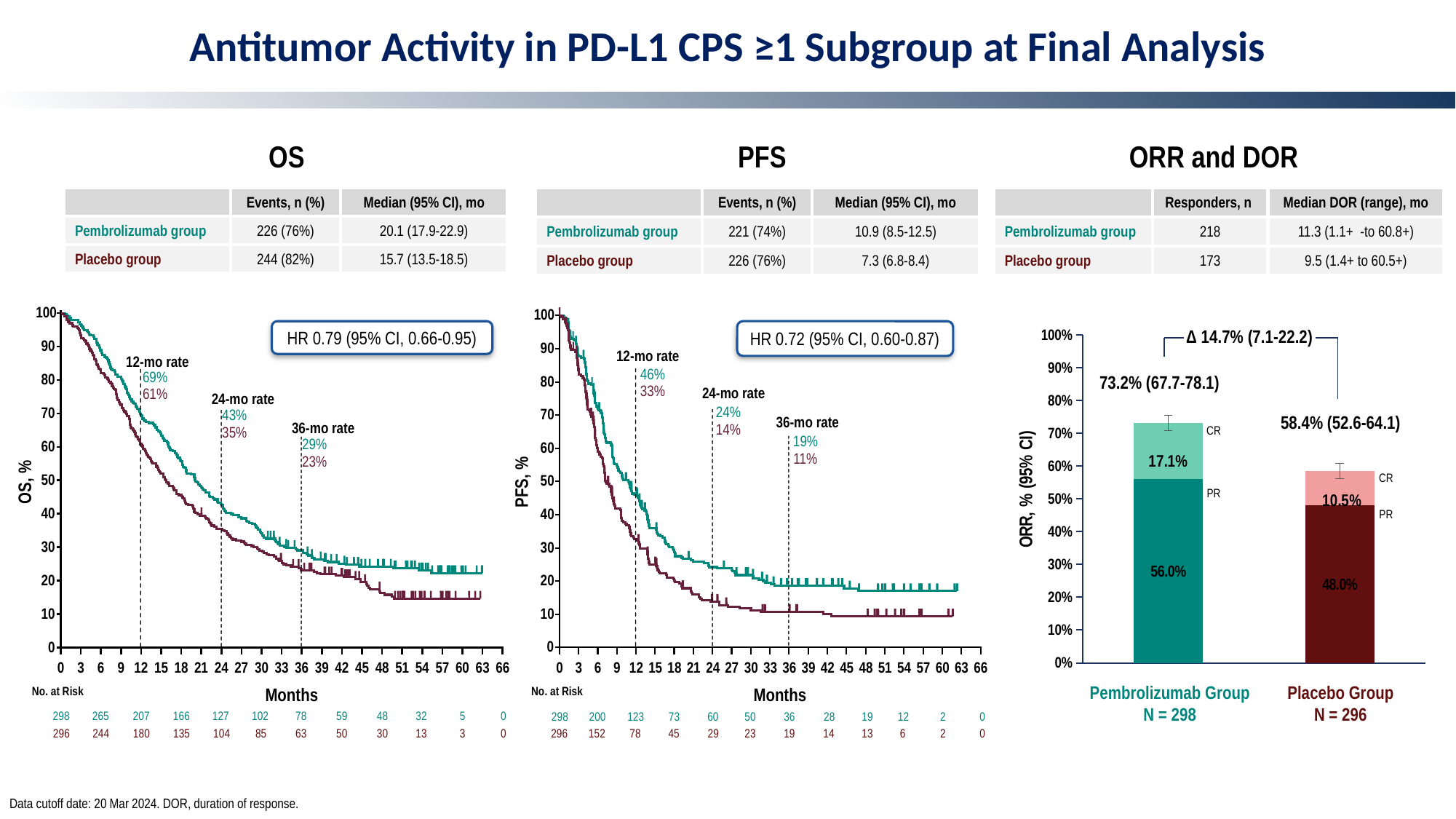
In the OS chart, what is the 12-mo rate for the pembrolizumab group? 69% What kind of chart is used to show ORR on the right of the slide? Bar chart In the ORR and DOR bar chart, what is the total ORR for the Pembrolizumab Group? 73.2% In the PFS chart, do the curves rise or fall as months increase? Fall In the ORR and DOR bar chart, which group has the higher overall response rate? Pembrolizumab Group In the ORR and DOR bar chart, what is the CR percentage for the Placebo Group? 10.5% In the ORR and DOR bar chart, how many groups are plotted on the x axis? 2 In the PFS chart, what is the 12-mo rate for the placebo group? 33% In the ORR and DOR bar chart, what is the PR percentage for the Pembrolizumab Group? 56.0% In the OS chart, what is the difference between the 24-mo rates of the pembrolizumab and placebo groups? 8% In the OS chart, what is the 36-mo rate for the placebo group? 23% In the ORR and DOR bar chart, what is the difference between the PR percentages of the Pembrolizumab Group and the Placebo Group? 8.0%